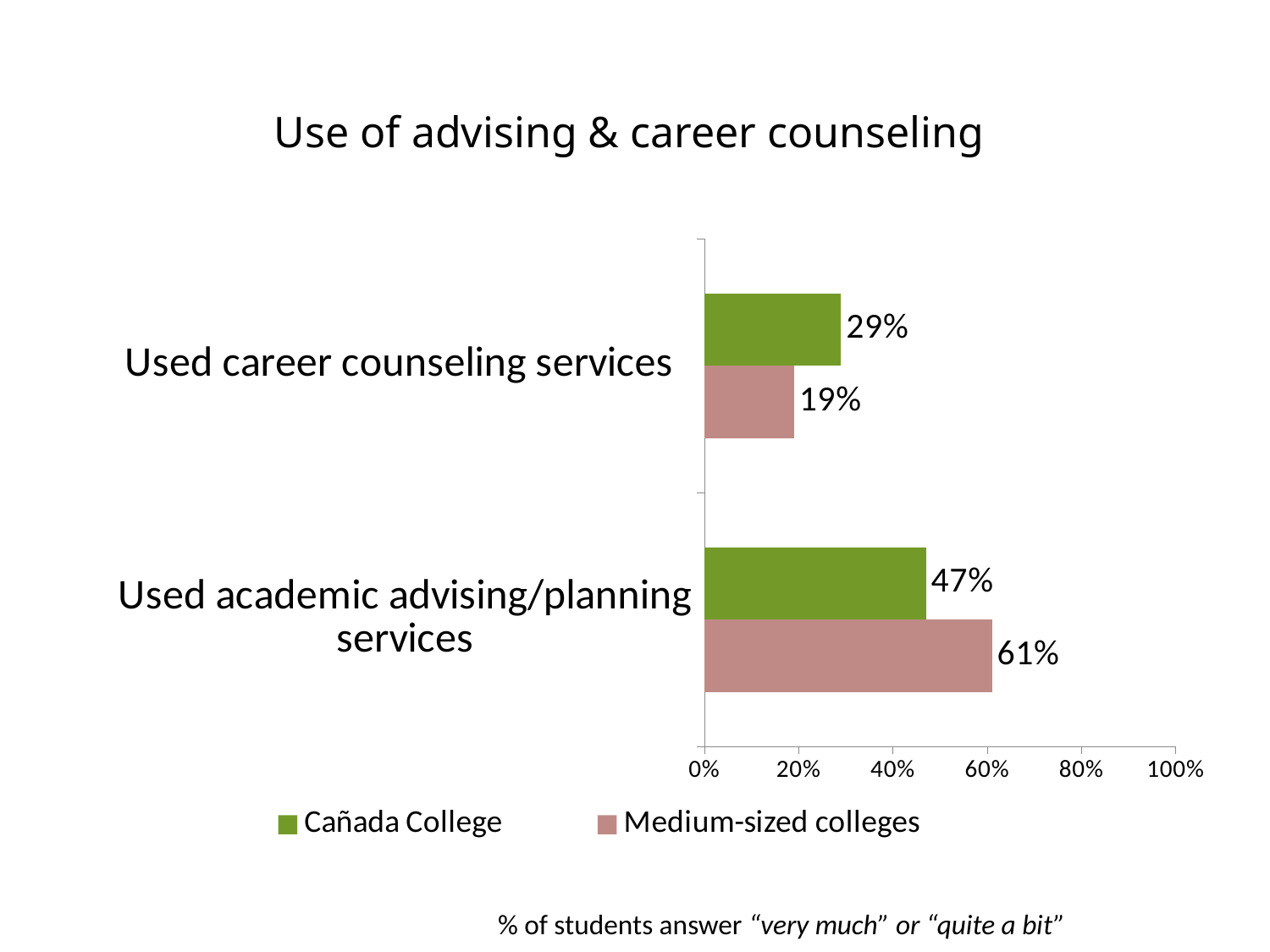
What percentage of students at medium-sized colleges used career counseling services? 19% Which category has the highest value for medium-sized colleges? Used academic advising/planning services How many series does the legend list? 2 What is the title of the chart? Use of advising & career counseling Which category has the lowest value for Cañada College? Used career counseling services What percentage of Cañada College students used career counseling services? 29% For career counseling services, which is larger: Cañada College or medium-sized colleges? Cañada College What percentage of Cañada College students used academic advising/planning services? 47% What percentage of students at medium-sized colleges used academic advising/planning services? 61% What kind of chart is shown on the slide? Bar chart What is the difference between medium-sized colleges and Cañada College for academic advising/planning services? 14% What is the difference between Cañada College and medium-sized colleges for career counseling services? 10%